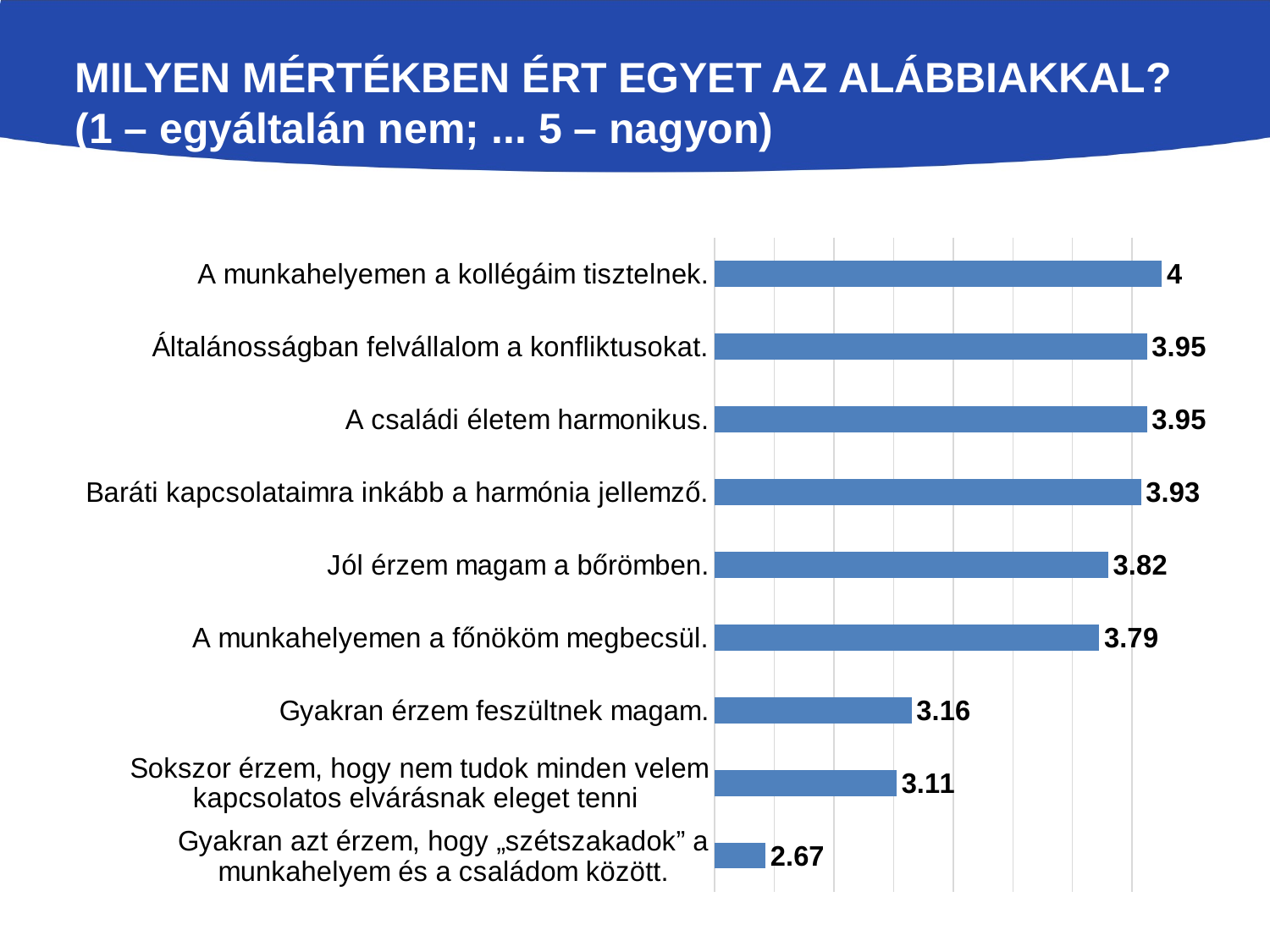
Which has a larger value: "Gyakran érzem feszültnek magam." or "Sokszor érzem, hogy nem tudok minden velem kapcsolatos elvárásnak eleget tenni"? Gyakran érzem feszültnek magam. What is the value for "Gyakran érzem feszültnek magam."? 3.16 What is the difference between the values for "Jól érzem magam a bőrömben." and "Gyakran érzem feszültnek magam."? 0.66 What is the value for "A munkahelyemen a főnököm megbecsül."? 3.79 What kind of chart is shown on the slide? Bar chart What is the difference between the values for "A munkahelyemen a kollégáim tisztelnek." and "Gyakran azt érzem, hogy „szétszakadok” a munkahelyem és a családom között."? 1.33 Which statement has the highest value? A munkahelyemen a kollégáim tisztelnek. Which statement has the lowest value? Gyakran azt érzem, hogy „szétszakadok” a munkahelyem és a családom között. How many statements are shown in the chart? 9 What is the value for "A munkahelyemen a kollégáim tisztelnek."? 4 What colour are the bars in the chart? Blue What is the value for "Jól érzem magam a bőrömben."? 3.82